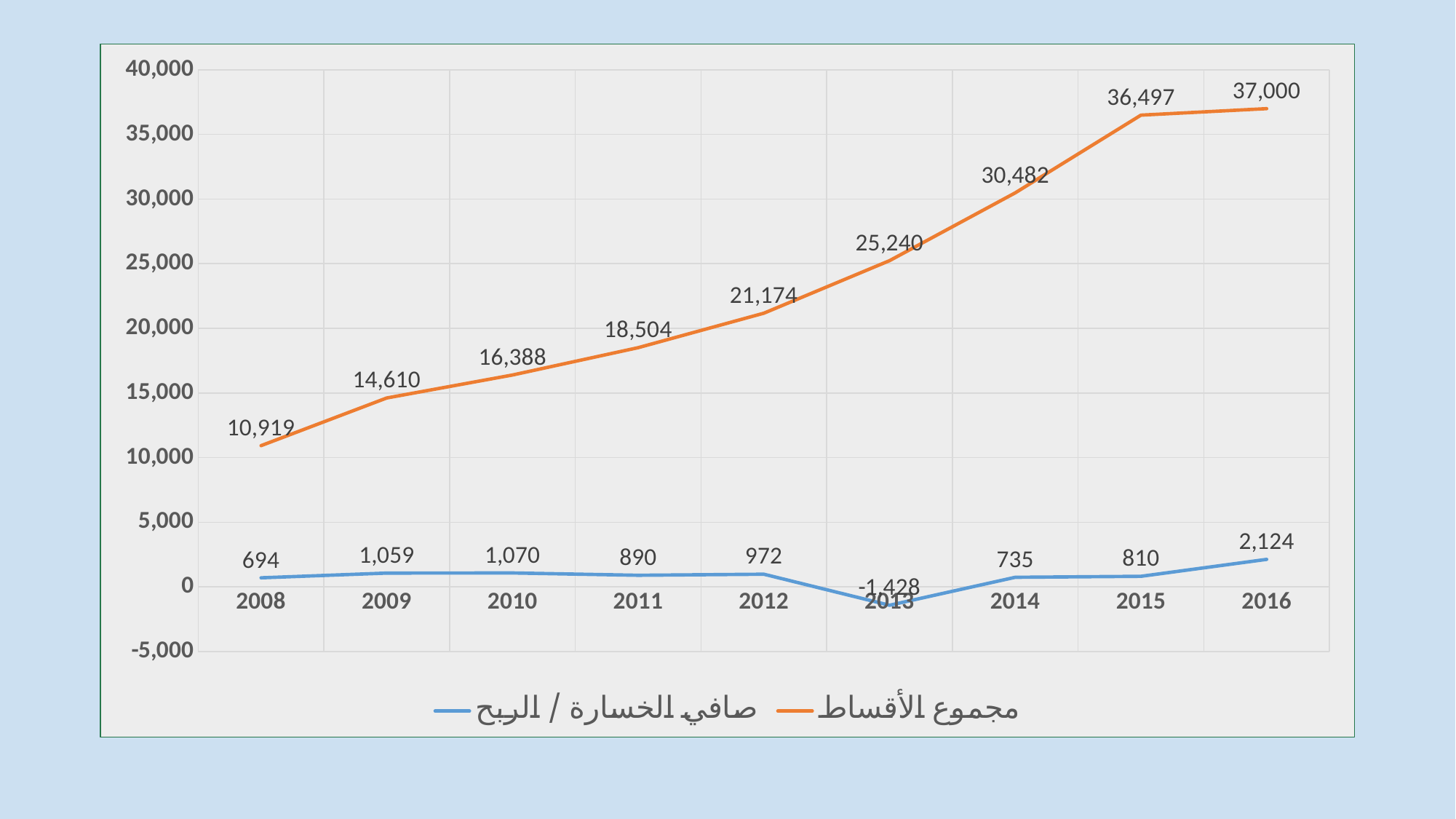
Which is larger, صافي الخسارة / الربح in 2010 or in 2011? 2010 What type of chart is shown on the slide? line chart What is the value of مجموع الأقساط in 2012? 21,174 What is the value of صافي الخسارة / الربح in 2013? -1,428 In which year is مجموع الأقساط highest? 2016 How many series does the legend list? 2 In which year is صافي الخسارة / الربح lowest? 2013 Which colour is the line for مجموع الأقساط? orange What is the value of مجموع الأقساط in 2008? 10,919 Does مجموع الأقساط rise or fall from 2008 to 2016? rise How many years are shown on the x axis? 9 What is the difference between مجموع الأقساط in 2016 and in 2015? 503